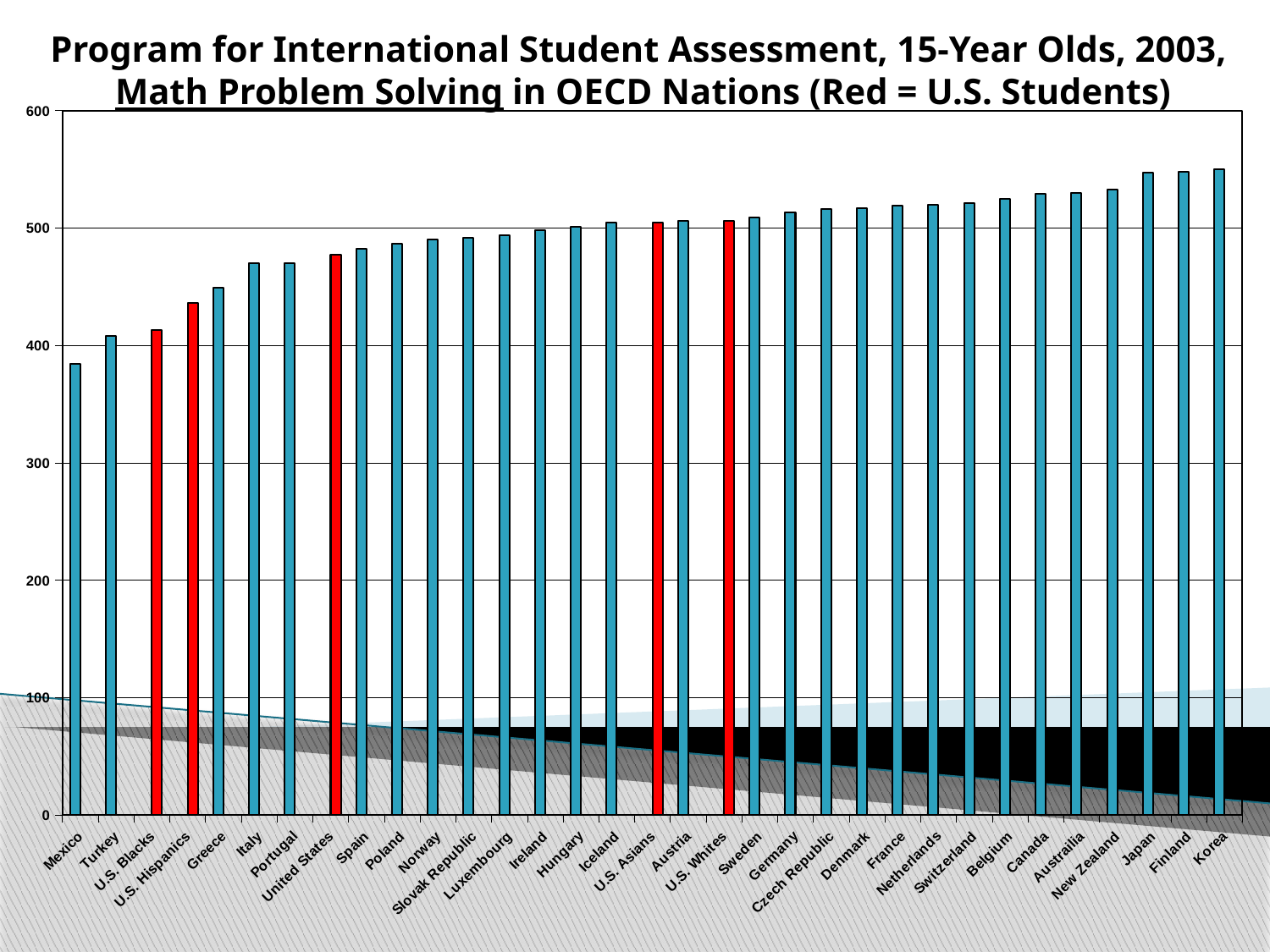
Which category has the lowest value? Mexico Is the value for Italy greater or less than 500? less How many bars are shown in the chart? 33 Which is larger, the value for U.S. Blacks or the value for U.S. Whites? U.S. Whites Is the value for Mexico greater or less than 400? less Is the value for U.S. Hispanics greater or less than 400? greater Do the values rise or fall moving from left to right along the x axis? rise What kind of chart is shown on the slide? bar chart Which is larger, the value for Greece or the value for Canada? Canada How many bars are coloured red in the chart? 5